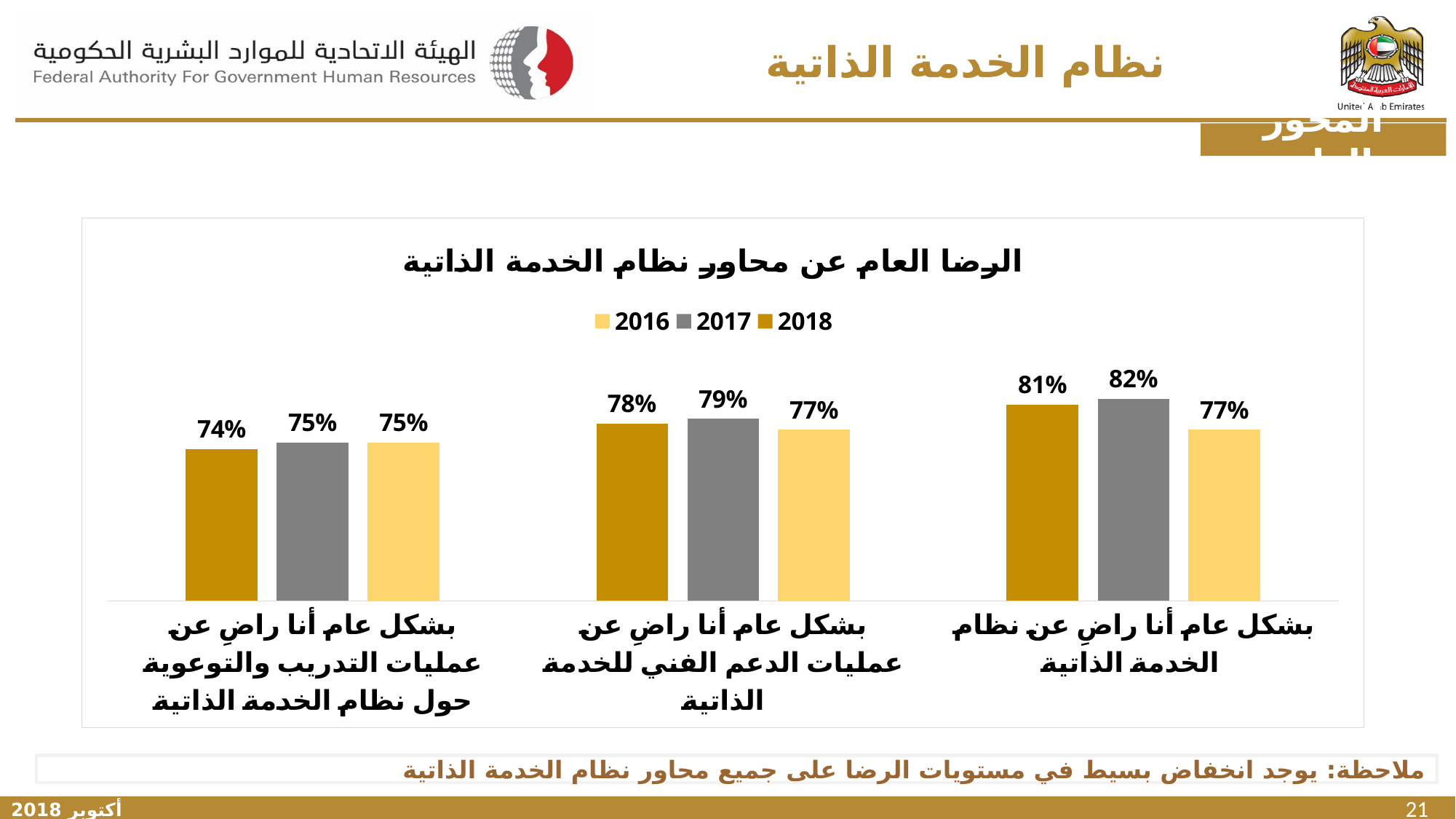
Which category has the highest 2018 value? بشكل عام أنا راضٍ عن نظام الخدمة الذاتية Which series is shown in gray in the chart? 2017 How many series does the legend list in the chart? 3 What type of chart is shown on the slide? Bar chart What is the 2018 value for 'بشكل عام أنا راضٍ عن نظام الخدمة الذاتية'? 81% What is the difference between the 2017 and 2018 values for 'بشكل عام أنا راضٍ عن نظام الخدمة الذاتية'? 1% Which category has the lowest 2017 value? بشكل عام أنا راضٍ عن عمليات التدريب والتوعوية حول نظام الخدمة الذاتية Which is larger for 'بشكل عام أنا راضٍ عن عمليات الدعم الفني للخدمة الذاتية': the 2016 value or the 2018 value? 2018 What is the 2017 value for 'بشكل عام أنا راضٍ عن عمليات الدعم الفني للخدمة الذاتية'? 79% How many categories are shown on the x axis of the chart? 3 What is the title of the chart? الرضا العام عن محاور نظام الخدمة الذاتية What is the 2016 value for 'بشكل عام أنا راضٍ عن عمليات التدريب والتوعوية حول نظام الخدمة الذاتية'? 75%